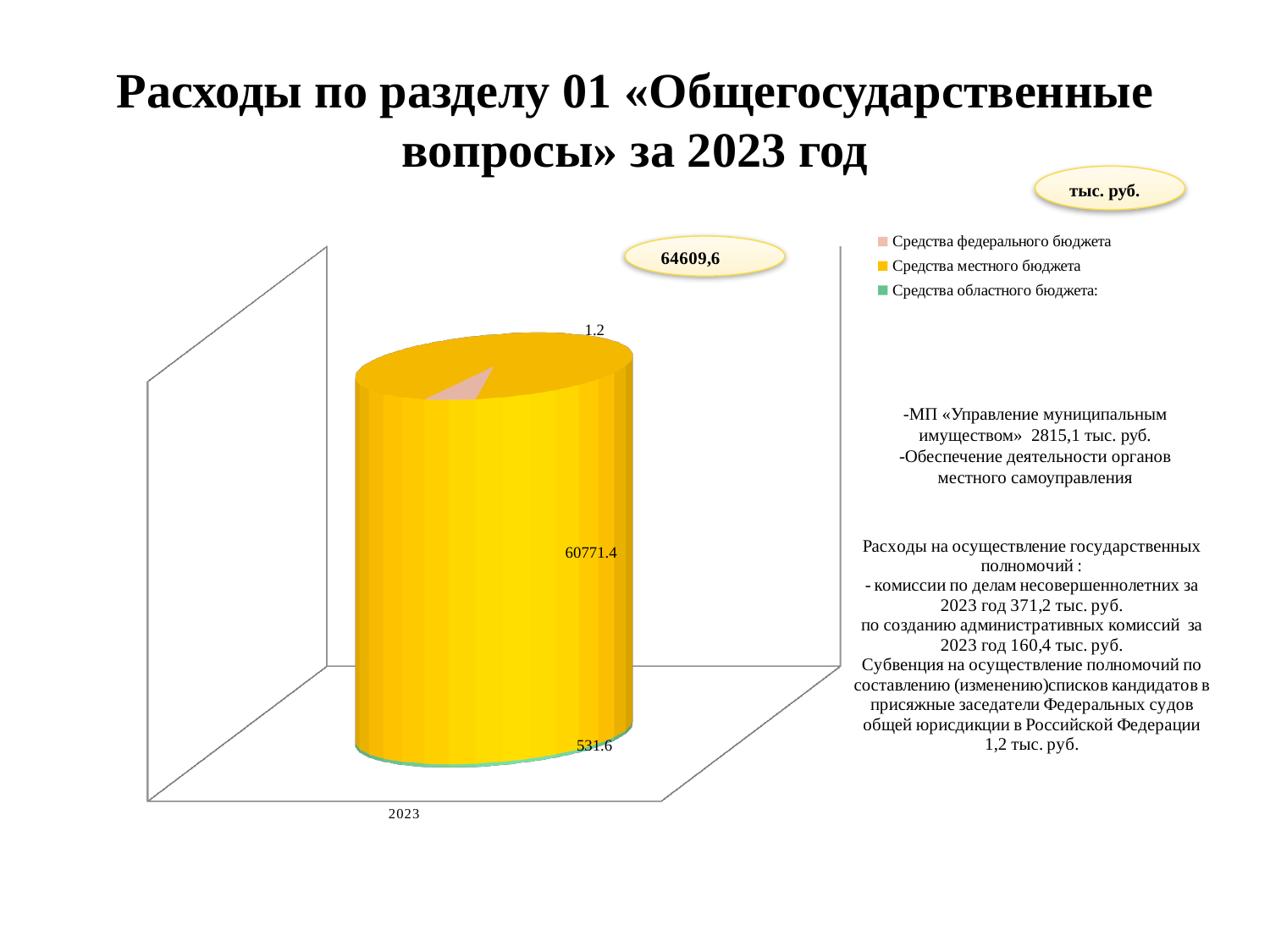
What kind of chart is shown on the slide? Stacked bar chart Which series has the highest value in the chart? Средства местного бюджета What is the value for «Средства федерального бюджета» in 2023? 1.2 What is the difference between «Средства областного бюджета» and «Средства федерального бюджета»? 530.4 What is the difference between «Средства местного бюджета» and «Средства областного бюджета»? 60239.8 What is the value for «Средства областного бюджета» in 2023? 531.6 How many categories are shown on the x axis of the chart? 1 Which is larger: «Средства областного бюджета» or «Средства федерального бюджета»? Средства областного бюджета What is the category label on the x axis of the chart? 2023 How many series does the legend list? 3 What is the value for «Средства местного бюджета» in 2023? 60771.4 Which series has the lowest value in the chart? Средства федерального бюджета